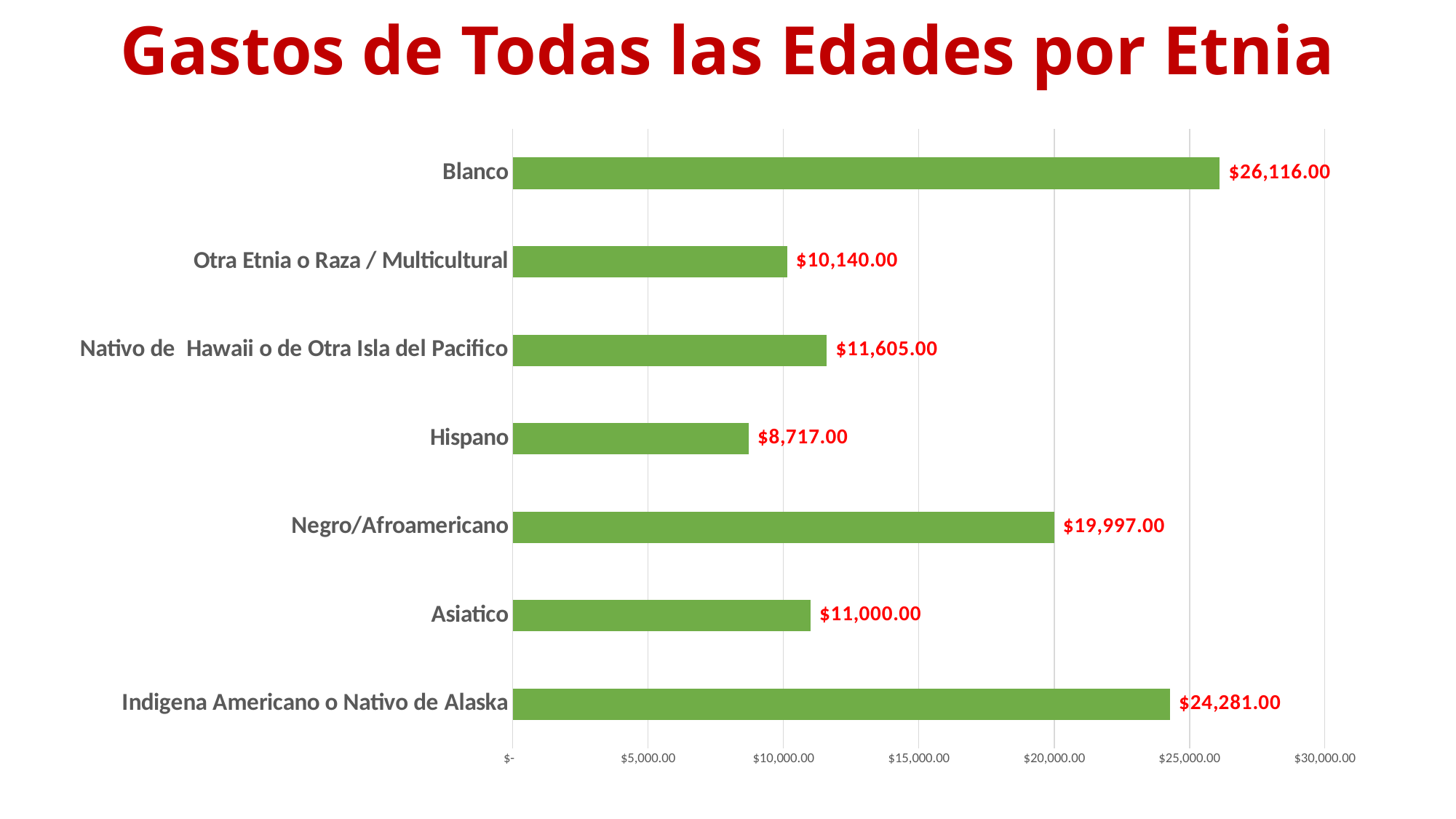
What is the value for Hispano? $8,717.00 Which is larger, the value for Asiatico or the value for Nativo de Hawaii o de Otra Isla del Pacifico? Nativo de Hawaii o de Otra Isla del Pacifico How many categories are shown in the chart? 7 What is the difference between the values for Blanco and Indigena Americano o Nativo de Alaska? $1,835.00 Which category has the highest value? Blanco What is the value for Indigena Americano o Nativo de Alaska? $24,281.00 Is the value for Negro/Afroamericano greater or less than $15,000.00? greater What is the title of the slide? Gastos de Todas las Edades por Etnia Which category has the lowest value? Hispano What is the value for Blanco? $26,116.00 What kind of chart is shown on the slide? bar chart What is the value for Negro/Afroamericano? $19,997.00